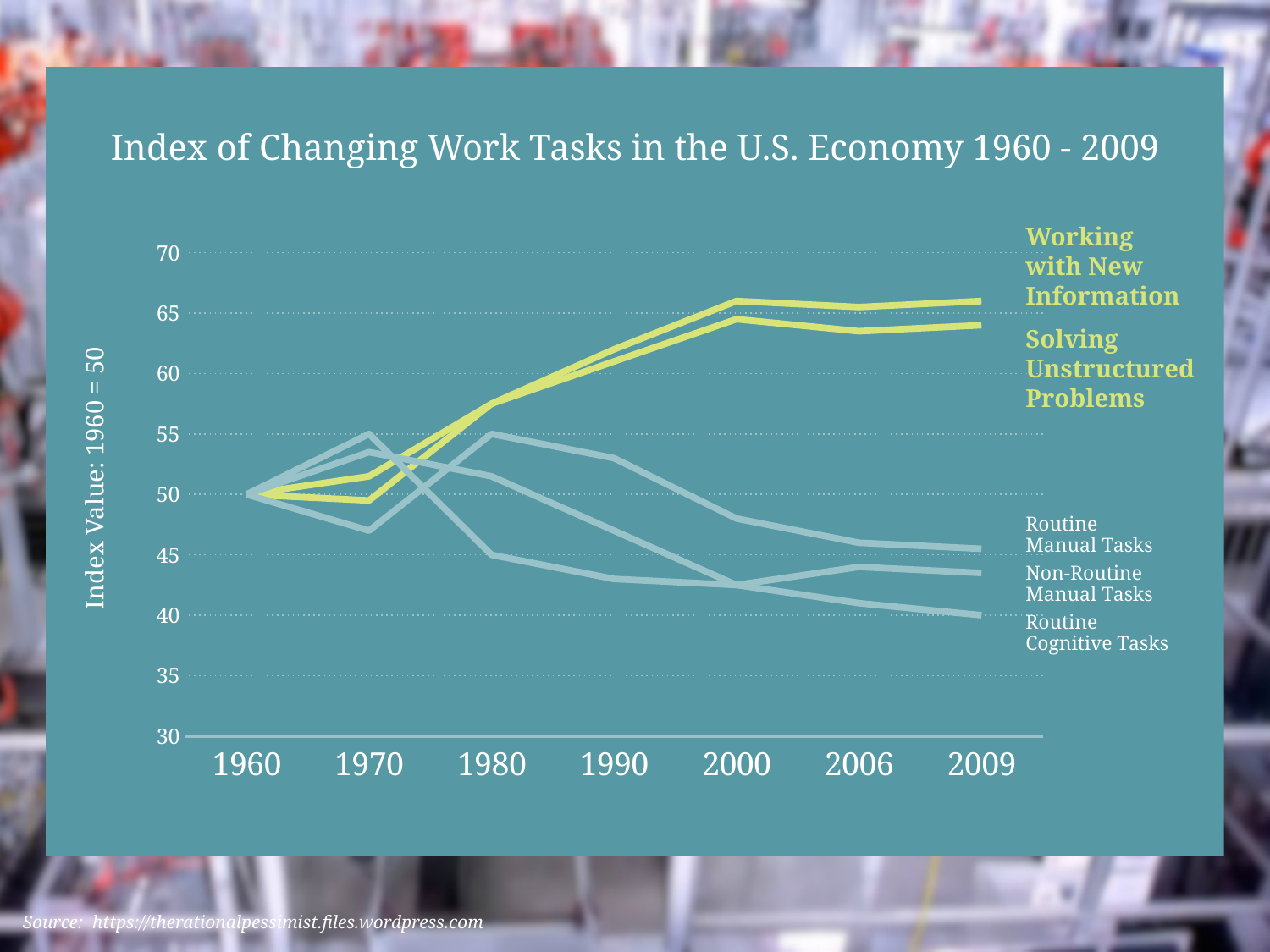
How many years are marked along the x axis? 7 Does the Routine Cognitive Tasks line rise or fall from 1980 to 2009? fall What is the index value for all task types in 1960? 50 In 2009, which is larger: Routine Manual Tasks or Routine Cognitive Tasks? Routine Manual Tasks What is the title of the chart? Index of Changing Work Tasks in the U.S. Economy 1960 - 2009 Is the value for Working with New Information in 2009 greater or less than 60? greater Is the value for Non-Routine Manual Tasks in 2009 greater or less than 50? less What type of chart is shown on the slide? Line chart Which task type has the lowest index value in 2009? Routine Cognitive Tasks How many series (task types) are plotted on the chart? 5 Which task type has the highest index value in 2009? Working with New Information Does the Solving Unstructured Problems line rise or fall from 1970 to 2000? rise